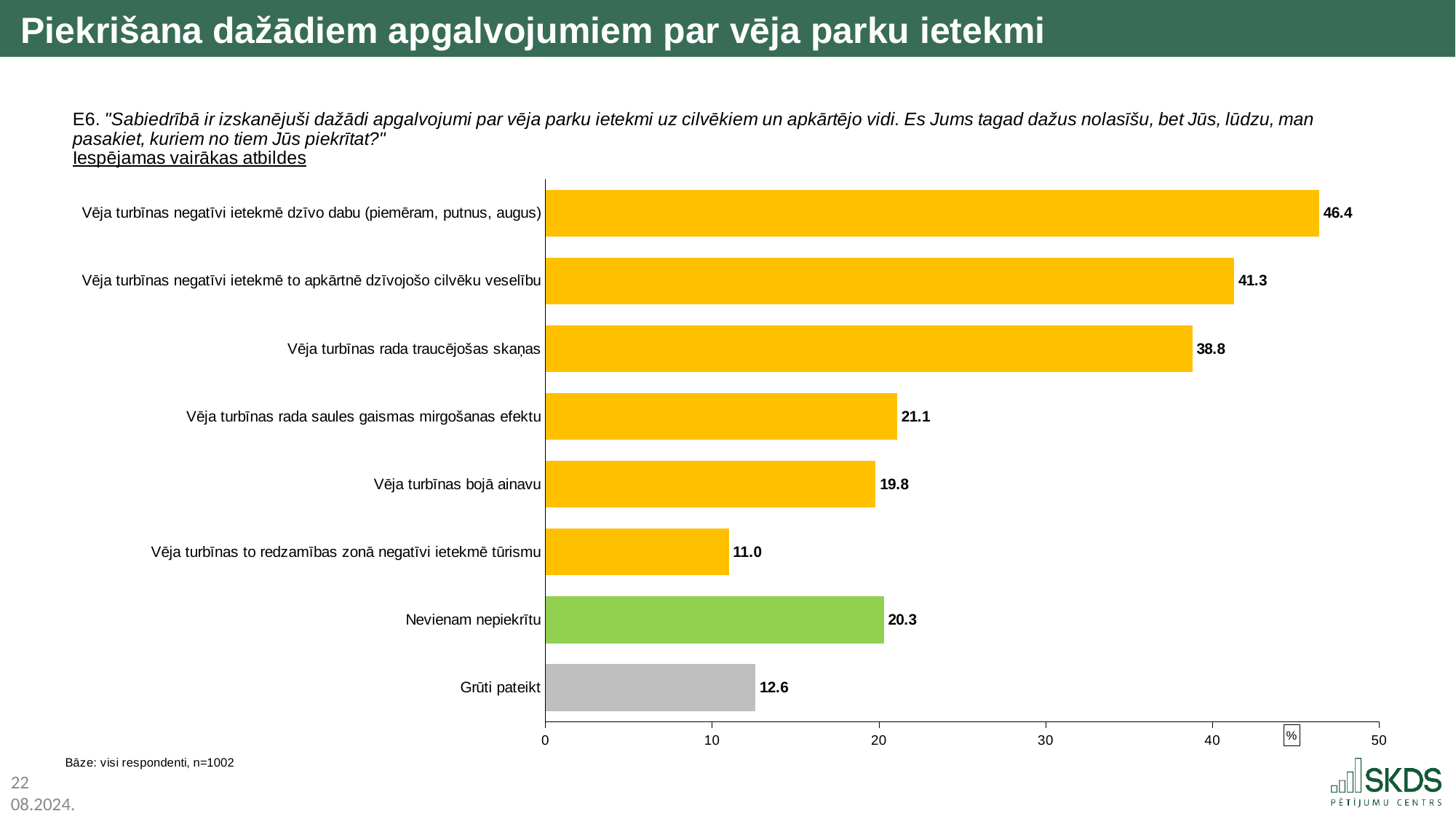
What is the value for "Nevienam nepiekrītu"? 20.3 Which category has the lowest value? Vēja turbīnas to redzamības zonā negatīvi ietekmē tūrismu Is the value for "Vēja turbīnas rada traucējošas skaņas" greater or less than 40? less What colour is the bar for "Nevienam nepiekrītu"? green How many categories are shown in the chart? 8 What is the value for "Grūti pateikt"? 12.6 Which category has the highest value? Vēja turbīnas negatīvi ietekmē dzīvo dabu (piemēram, putnus, augus) What is the value for "Vēja turbīnas negatīvi ietekmē dzīvo dabu (piemēram, putnus, augus)"? 46.4 Which is larger: the value for "Vēja turbīnas rada saules gaismas mirgošanas efektu" or for "Nevienam nepiekrītu"? Vēja turbīnas rada saules gaismas mirgošanas efektu What is the value for "Vēja turbīnas bojā ainavu"? 19.8 What kind of chart is shown on the slide? bar chart What is the difference between the values for "Vēja turbīnas negatīvi ietekmē dzīvo dabu (piemēram, putnus, augus)" and "Vēja turbīnas negatīvi ietekmē to apkārtnē dzīvojošo cilvēku veselību"? 5.1